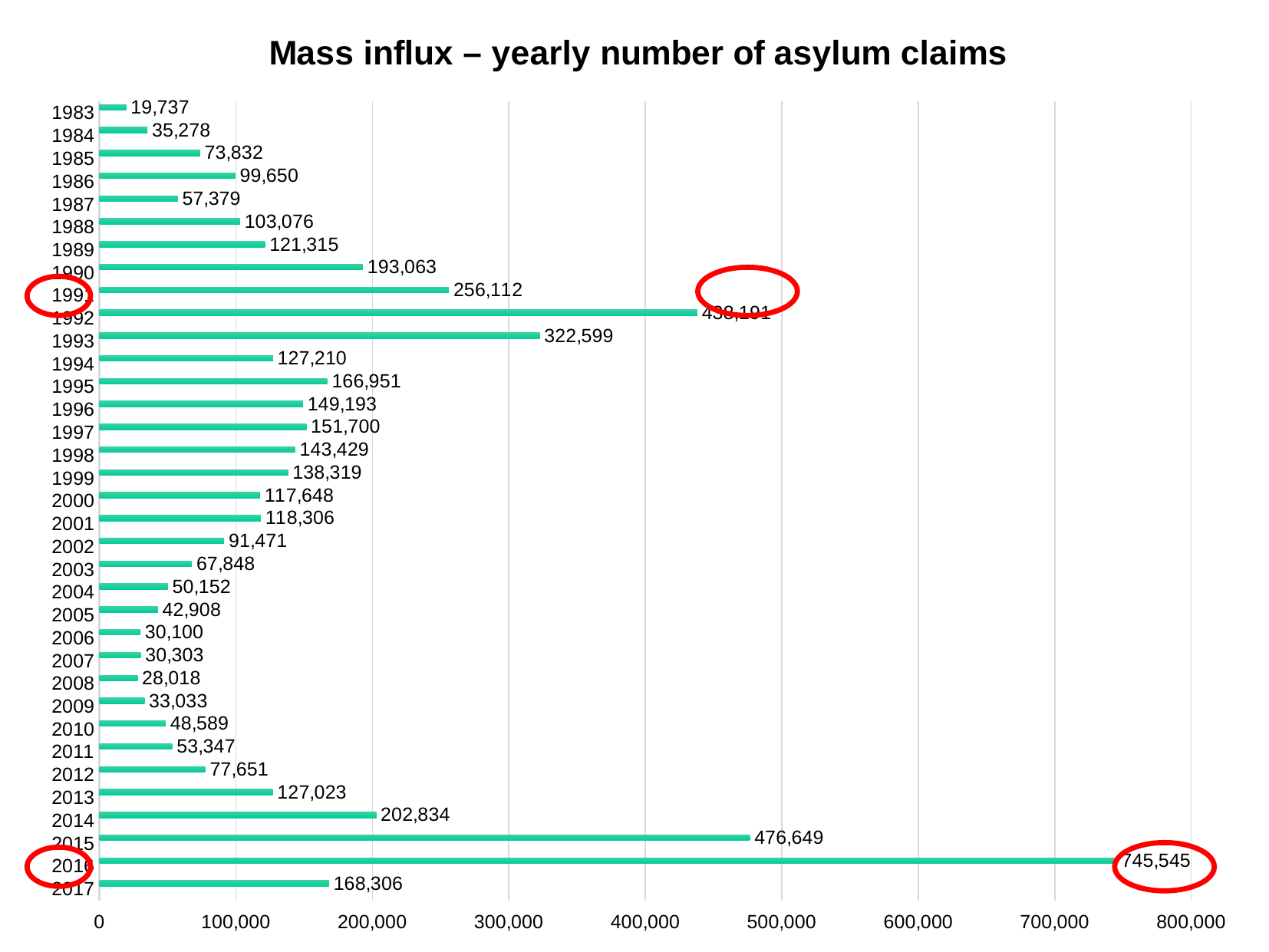
What is the number of asylum claims for 2016? 745,545 What is the difference between the number of asylum claims in 2016 and in 2015? 268,896 Which year has the highest number of asylum claims? 2016 What type of chart is shown on the slide? bar chart What is the number of asylum claims for 2015? 476,649 What is the number of asylum claims for 1983? 19,737 What is the number of asylum claims for 2017? 168,306 Is the value for 1992 greater or less than 400,000? greater Do the values rise or fall from 2008 to 2016? rise Which year has the lowest number of asylum claims? 1983 How many years are shown on the chart? 35 Which year has more asylum claims, 1990 or 1993? 1993